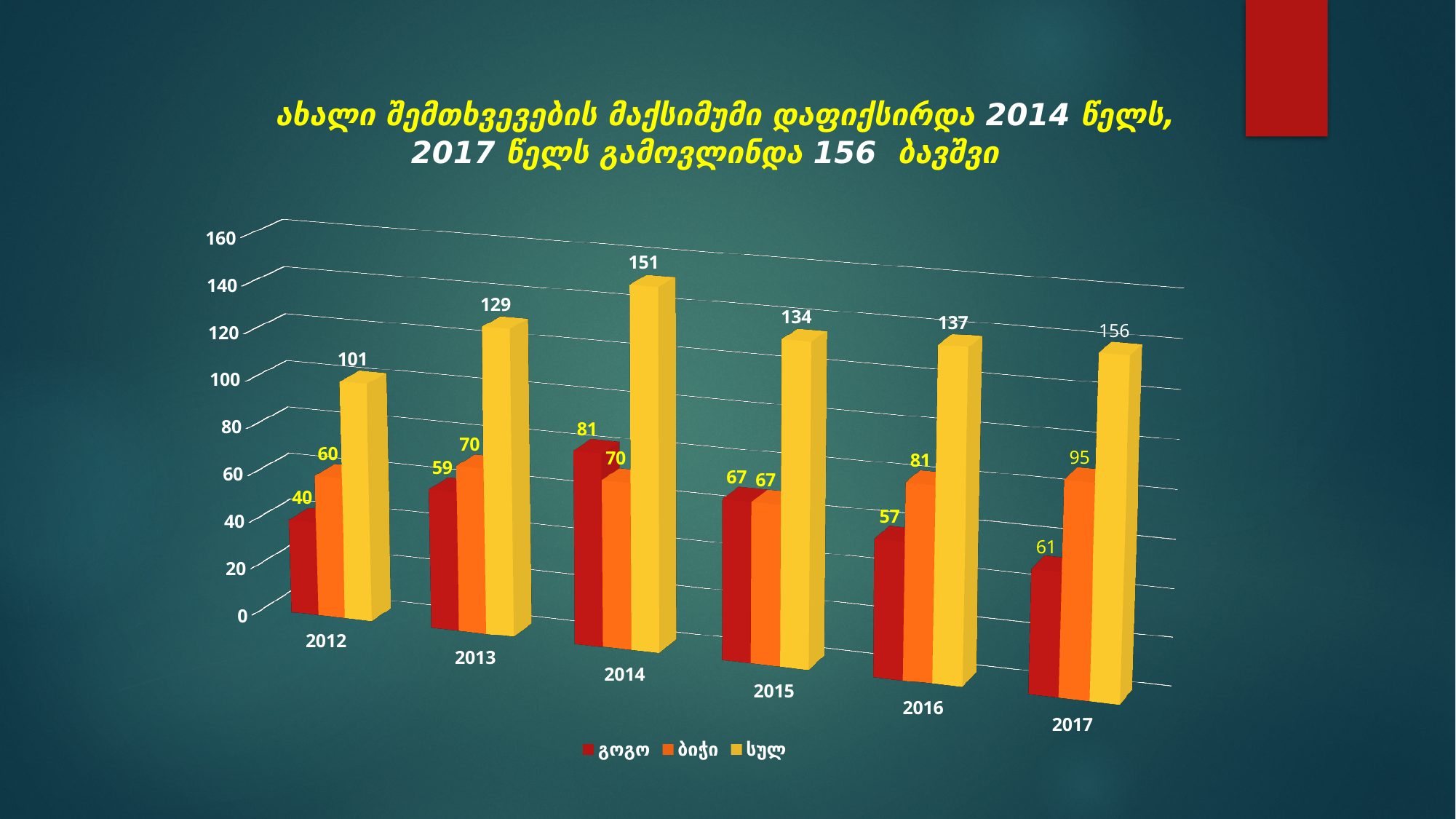
Is the value for სულ in 2013 greater or less than 120? greater Which series is shown in yellow? სულ What is the value for ბიჭი in 2017? 95 What is the value for გოგო in 2012? 40 What is the difference between the სულ values for 2017 and 2014? 5 How many series does the legend list? 3 What kind of chart is shown on the slide? bar chart What is the value for სულ in 2014? 151 Which is larger in 2016, გოგო or ბიჭი? ბიჭი How many years are shown on the x axis? 6 In which year is the გოგო series lowest? 2012